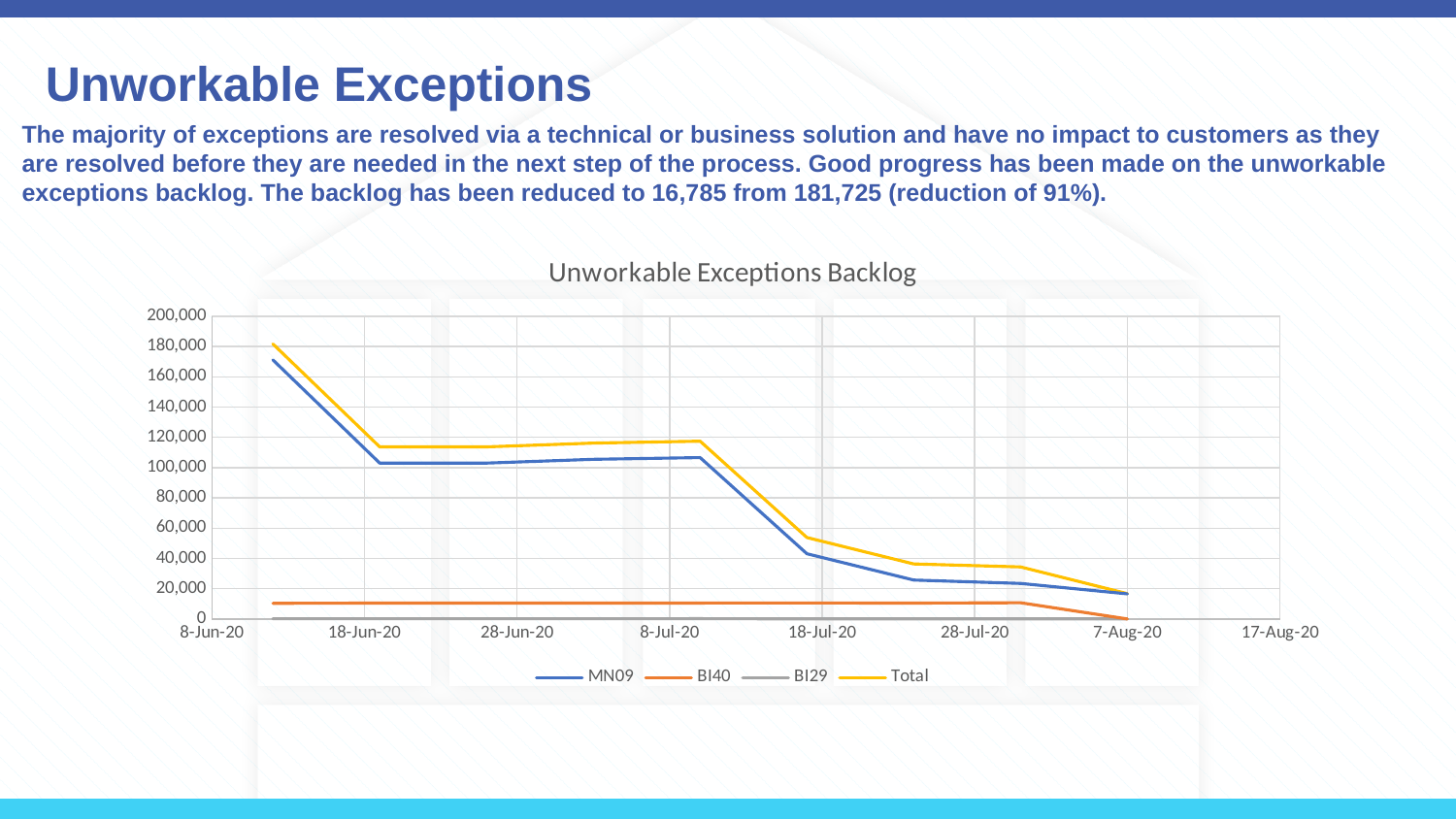
Is the value of the MN09 series at 7-Aug-20 greater or less than 20,000? less What is the title of the chart? Unworkable Exceptions Backlog Which series has the highest values across the chart? Total Which series is plotted in yellow? Total Is the value of the Total series at 18-Jul-20 greater or less than 60,000? less Is the first plotted value of the Total series greater or less than 160,000? greater How many series does the chart legend list? 4 At the first plotted point, which series is larger, Total or MN09? Total Which series has the lowest values across the chart? BI29 Does the Total series rise or fall overall from left to right along the x axis? fall What kind of chart is shown on the slide? line chart